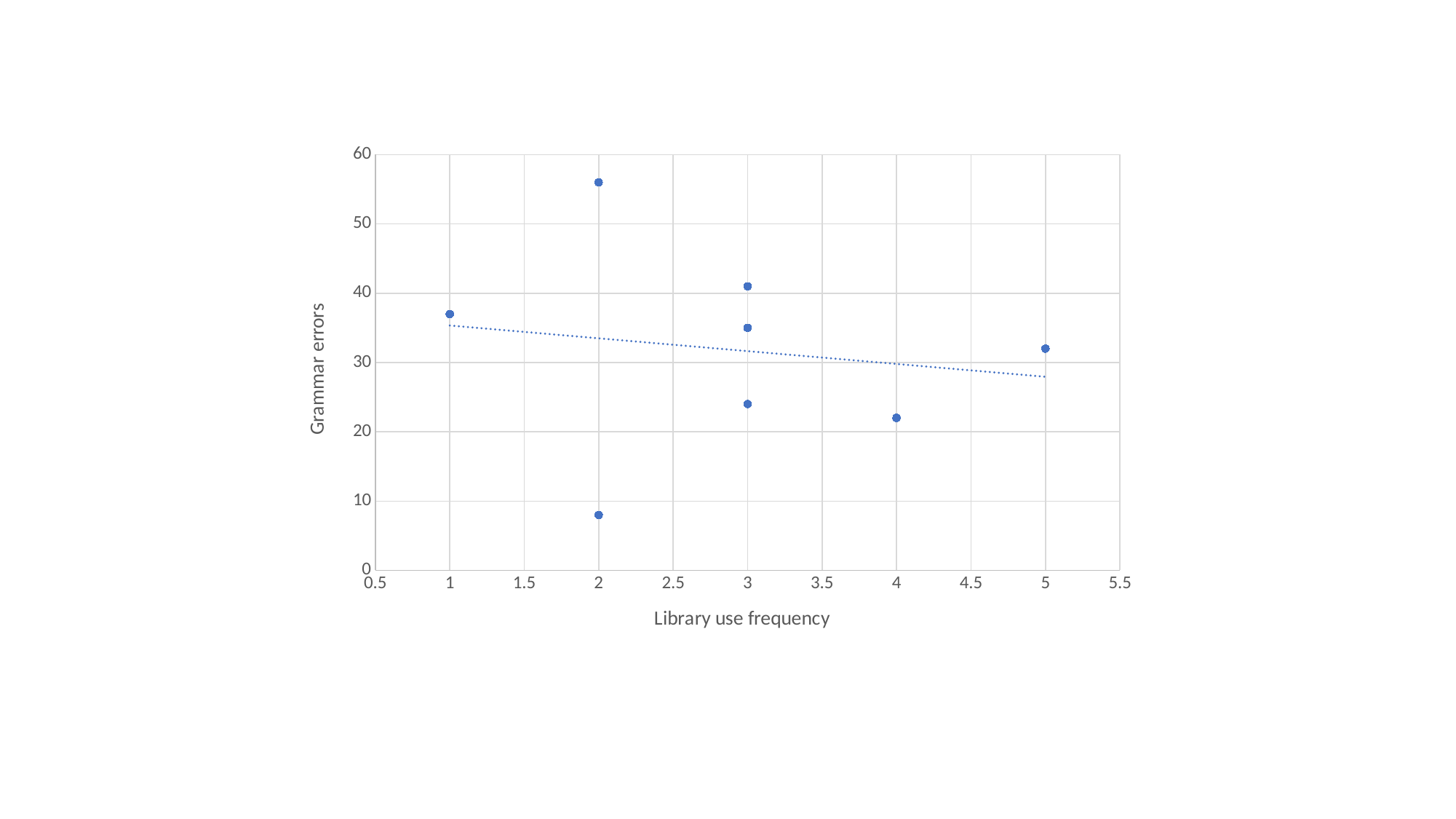
At which library use frequency is the point with the highest number of grammar errors? 2 Is the grammar errors value for the point at library use frequency 4 greater or less than 30? less What is the title of the y axis? Grammar errors How many data points are plotted at a library use frequency of 3? 3 How many data points are plotted on the chart? 8 Is the grammar errors value for the point at library use frequency 1 greater or less than 40? less Is the grammar errors value for the highest point at library use frequency 2 greater or less than 50? greater What kind of chart is shown on the slide? scatter chart At which library use frequency is the point with the lowest number of grammar errors? 2 Does the dotted trendline rise or fall as library use frequency increases? fall What is the title of the x axis? Library use frequency Which has more grammar errors: the point at library use frequency 1 or the point at library use frequency 4? library use frequency 1